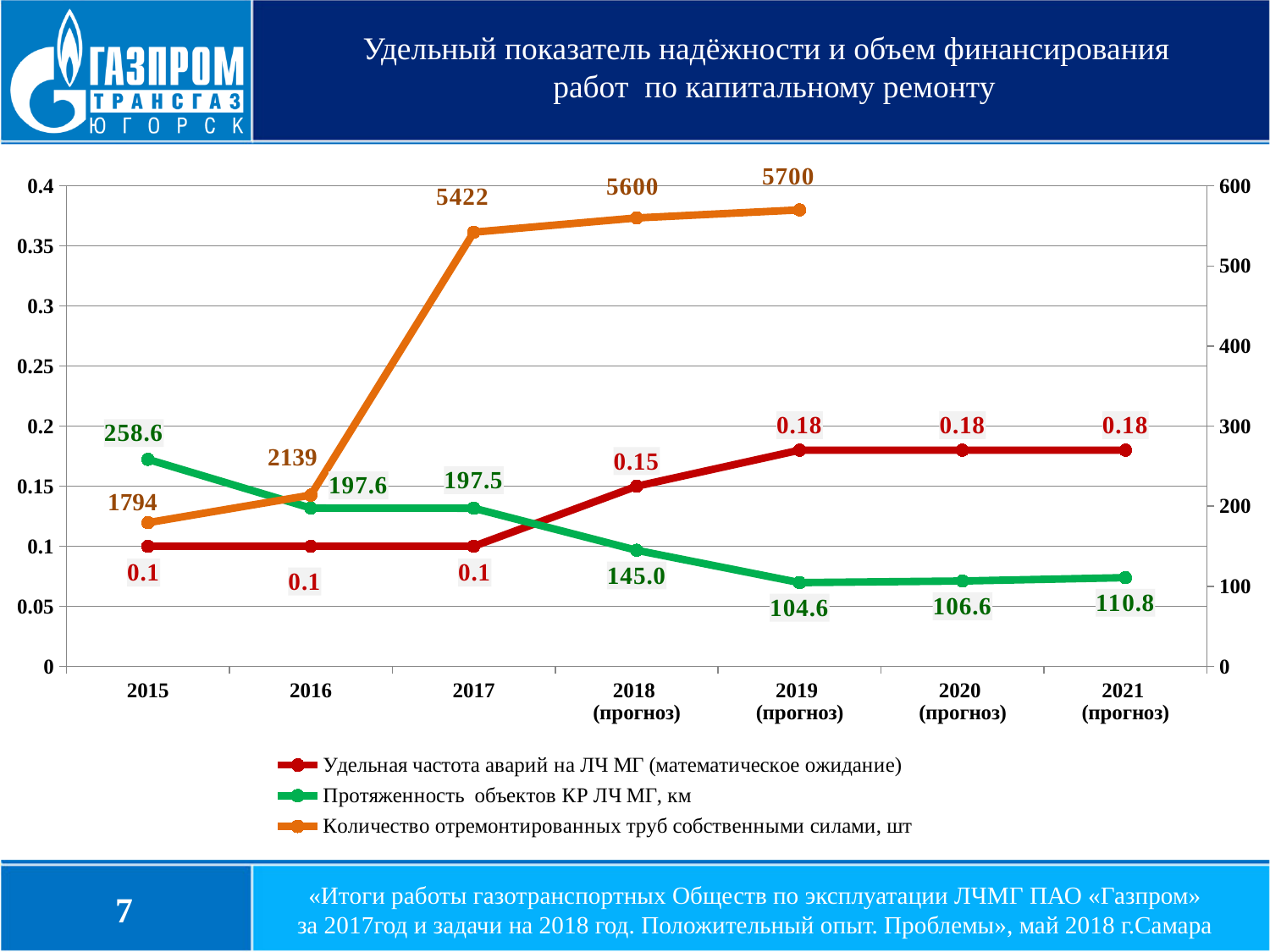
What is the difference between the 2017 and 2016 values of the series «Количество отремонтированных труб собственными силами, шт»? 3283 In which year is the series «Количество отремонтированных труб собственными силами, шт» at its highest? 2019 (прогноз) Does the series «Удельная частота аварий на ЛЧ МГ» rise or fall from 2017 to 2019 (прогноз)? Rise What kind of chart is shown on the slide? Line chart What is the value of the series «Протяженность объектов КР ЛЧ МГ, км» for 2015? 258.6 How many series does the legend list? 3 What is the difference between the 2015 and 2016 values of the series «Протяженность объектов КР ЛЧ МГ, км»? 61.0 What is the value of the series «Удельная частота аварий на ЛЧ МГ» for 2018 (прогноз)? 0.15 What is the value of the series «Количество отремонтированных труб собственными силами, шт» for 2017? 5422 In which year is the series «Протяженность объектов КР ЛЧ МГ, км» at its lowest? 2019 (прогноз) How many years are shown on the x axis? 7 Which is larger for the series «Протяженность объектов КР ЛЧ МГ, км»: the value for 2018 (прогноз) or the value for 2021 (прогноз)? 2018 (прогноз)